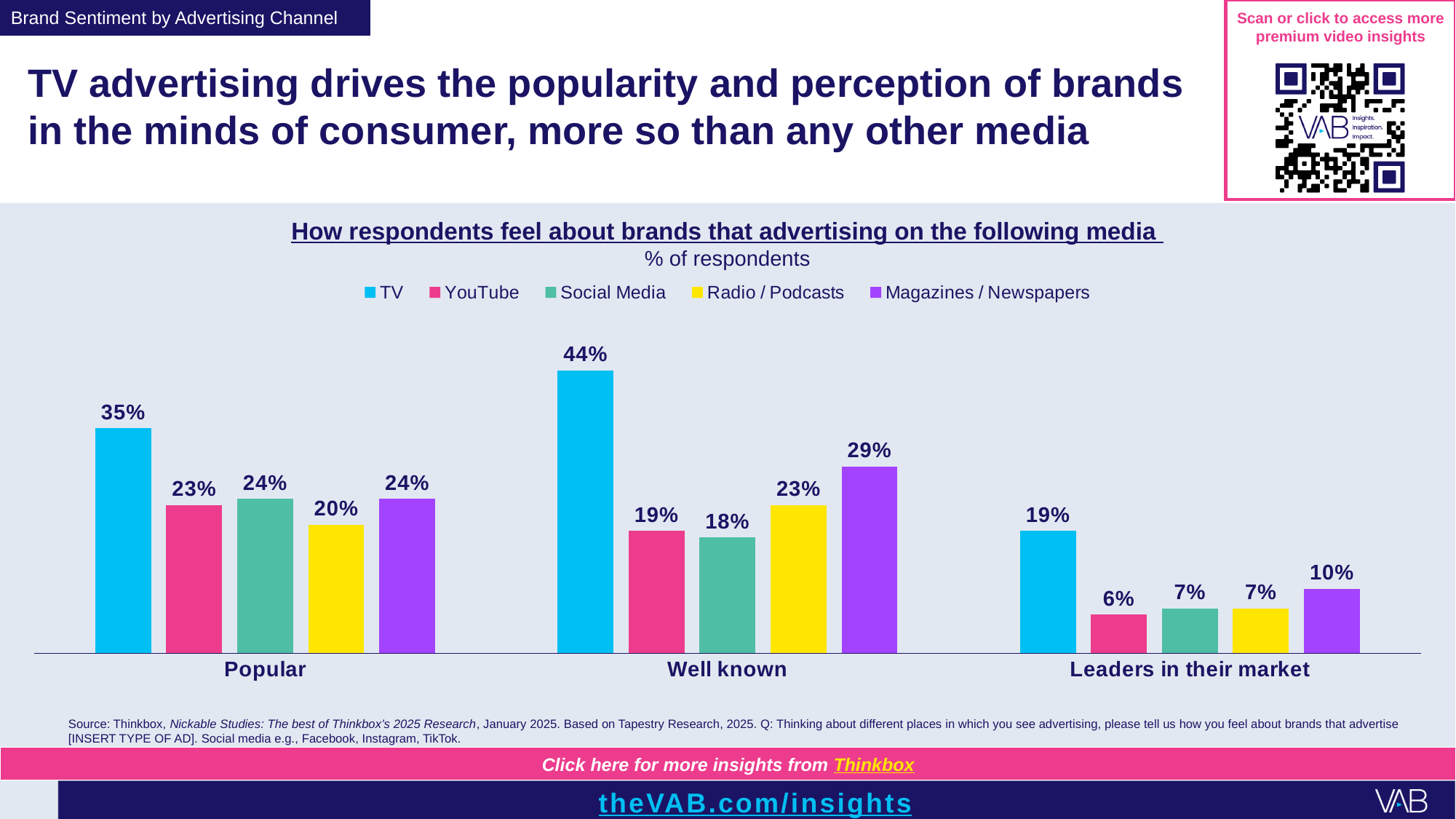
How does the TV value change across the categories from Popular to Leaders in their market? It rises from 35% to 44%, then falls to 19% Which advertising channel has the highest value in the Well known category? TV Which advertising channel has the lowest value in the Leaders in their market category? YouTube What percentage of respondents feel brands that advertise on TV are Popular? 35% What kind of chart is shown on the slide? Bar chart How many series does the legend list? 5 How many categories are shown on the x axis? 3 What colour represents Radio / Podcasts in the chart? Yellow What is the difference between the TV and YouTube values in the Well known category? 25% What is the value for Magazines / Newspapers in the Well known category? 29% Which is larger in the Popular category: Social Media or Radio / Podcasts? Social Media What is the value for YouTube in the Leaders in their market category? 6%